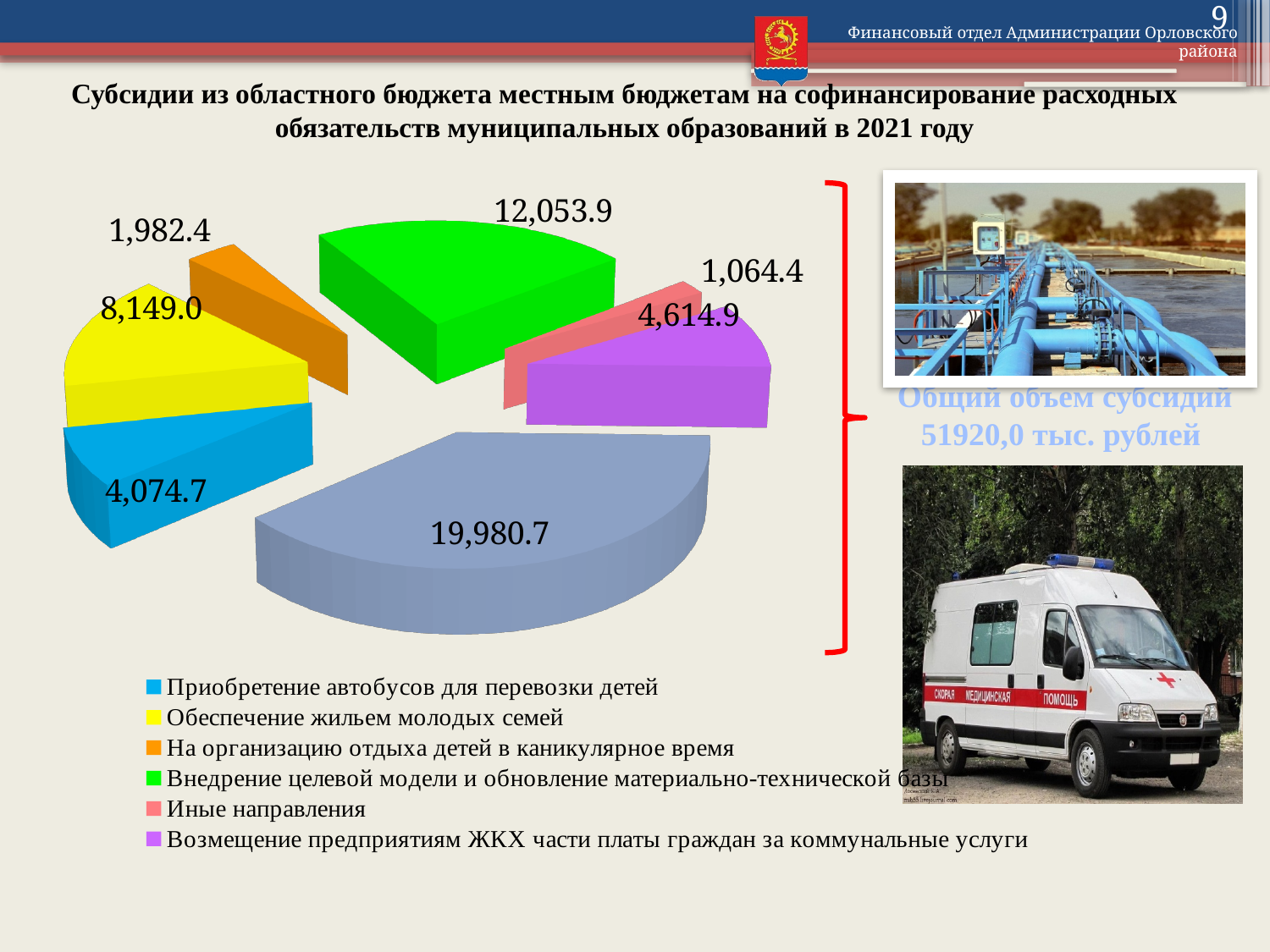
Which legend category has the smallest slice in the pie chart? Иные направления What is the value of the pie slice for «Внедрение целевой модели и обновление материально-технической базы»? 12,053.9 How many slices does the pie chart have? 7 What colour is the slice for «Обеспечение жильем молодых семей»? Yellow Which is larger: the slice for «Возмещение предприятиям ЖКХ части платы граждан за коммунальные услуги» or the slice for «Приобретение автобусов для перевозки детей»? Возмещение предприятиям ЖКХ части платы граждан за коммунальные услуги What is the value of the pie slice for «Приобретение автобусов для перевозки детей»? 4,074.7 What is the value of the pie slice for «Обеспечение жильем молодых семей»? 8,149.0 What is the value printed on the largest slice of the pie chart? 19,980.7 What is the value of the pie slice for «На организацию отдыха детей в каникулярное время»? 1,982.4 How much larger is the value for «Внедрение целевой модели и обновление материально-технической базы» than the value for «Обеспечение жильем молодых семей»? 3,904.9 What type of chart is shown on the slide? Pie chart What is the value of the pie slice for «Возмещение предприятиям ЖКХ части платы граждан за коммунальные услуги»? 4,614.9